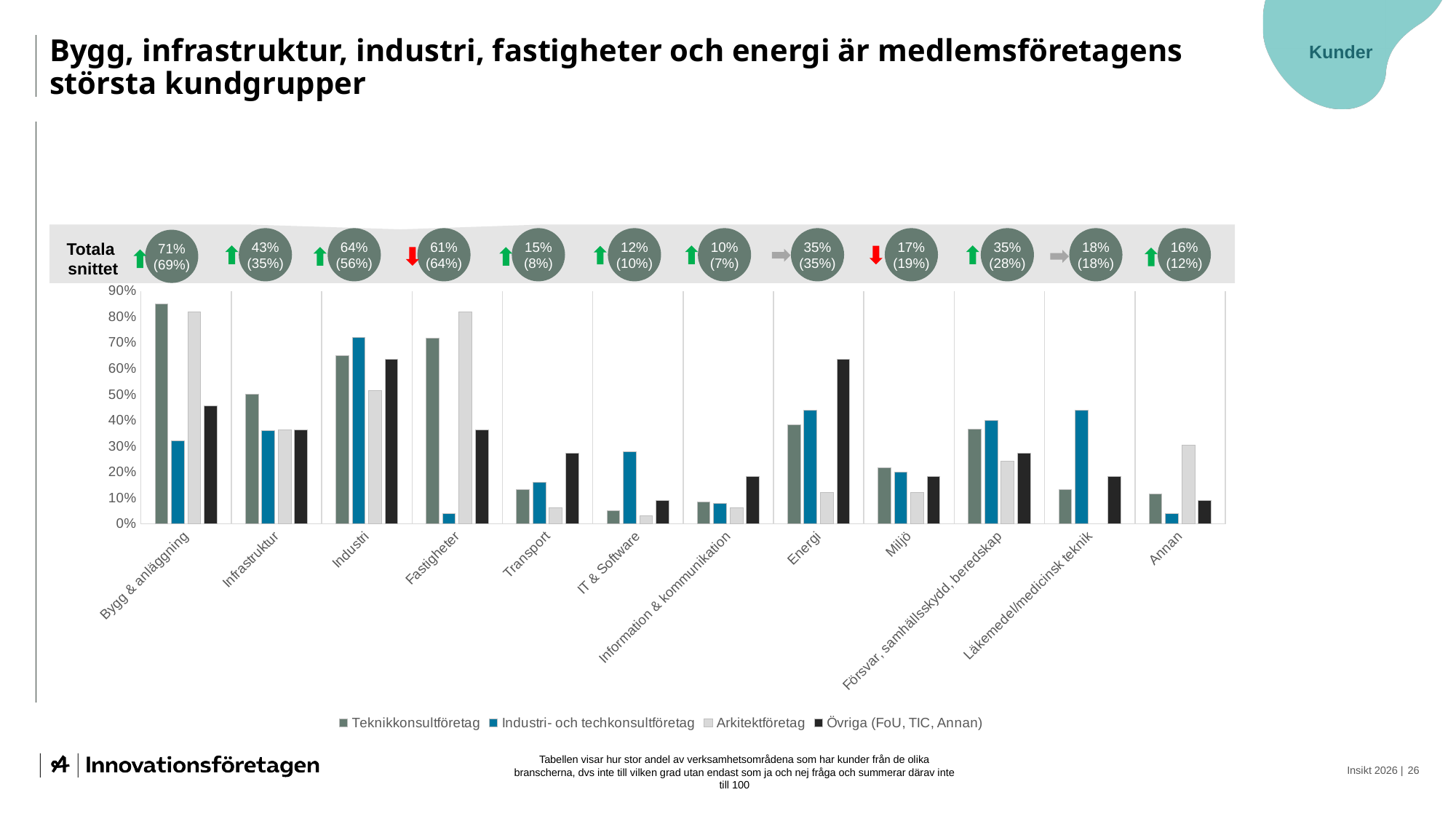
Which series has the lowest bar for Fastigheter? Industri- och techkonsultföretag What kind of chart is shown on the slide? bar chart What is the 'Totala snittet' value shown above Bygg & anläggning? 71% What is the 'Totala snittet' value shown above Energi? 35% What colour represents Industri- och techkonsultföretag in the legend? blue Is the Teknikkonsultföretag value for Bygg & anläggning greater or less than 80%? greater How many series does the legend list? 4 Which category has the highest Teknikkonsultföretag bar? Bygg & anläggning For Energi, which is larger: the Övriga (FoU, TIC, Annan) bar or the Teknikkonsultföretag bar? Övriga (FoU, TIC, Annan) How many customer categories are shown along the x axis? 12 Is the Arkitektföretag value for Annan greater or less than 20%? greater What is the value in parentheses shown in the 'Totala snittet' circle above Fastigheter? 64%